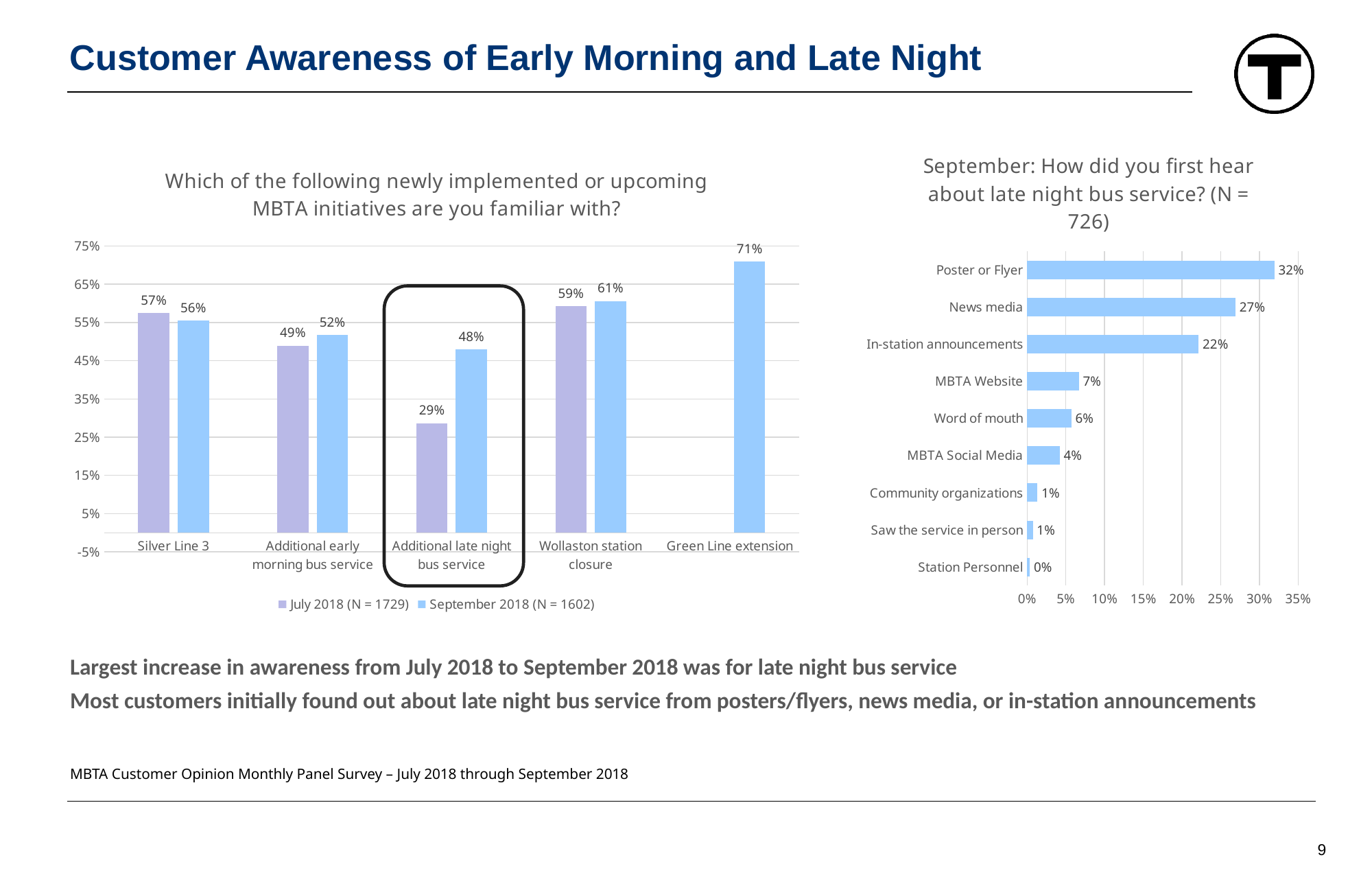
In the left chart ("Which of the following newly implemented or upcoming MBTA initiatives are you familiar with?"), what is the September 2018 value for Additional late night bus service? 48% In the left chart, what is the July 2018 value for Silver Line 3? 57% In the right chart, what is the difference between Poster or Flyer and In-station announcements? 10% How many initiatives are shown on the x axis of the left chart? 5 In the left chart, which initiative has the highest September 2018 value? Green Line extension In the right chart ("September: How did you first hear about late night bus service?"), what is the value for News media? 27% In the right chart, which source has the highest value? Poster or Flyer In the left chart, which is larger for Wollaston station closure: the July 2018 value or the September 2018 value? September 2018 What kind of chart is the right chart? Bar chart In the left chart, which initiative has the lowest July 2018 value? Additional late night bus service In the left chart, what is the difference between the September 2018 and July 2018 values for Additional late night bus service? 19% How many series does the legend of the left chart list? 2